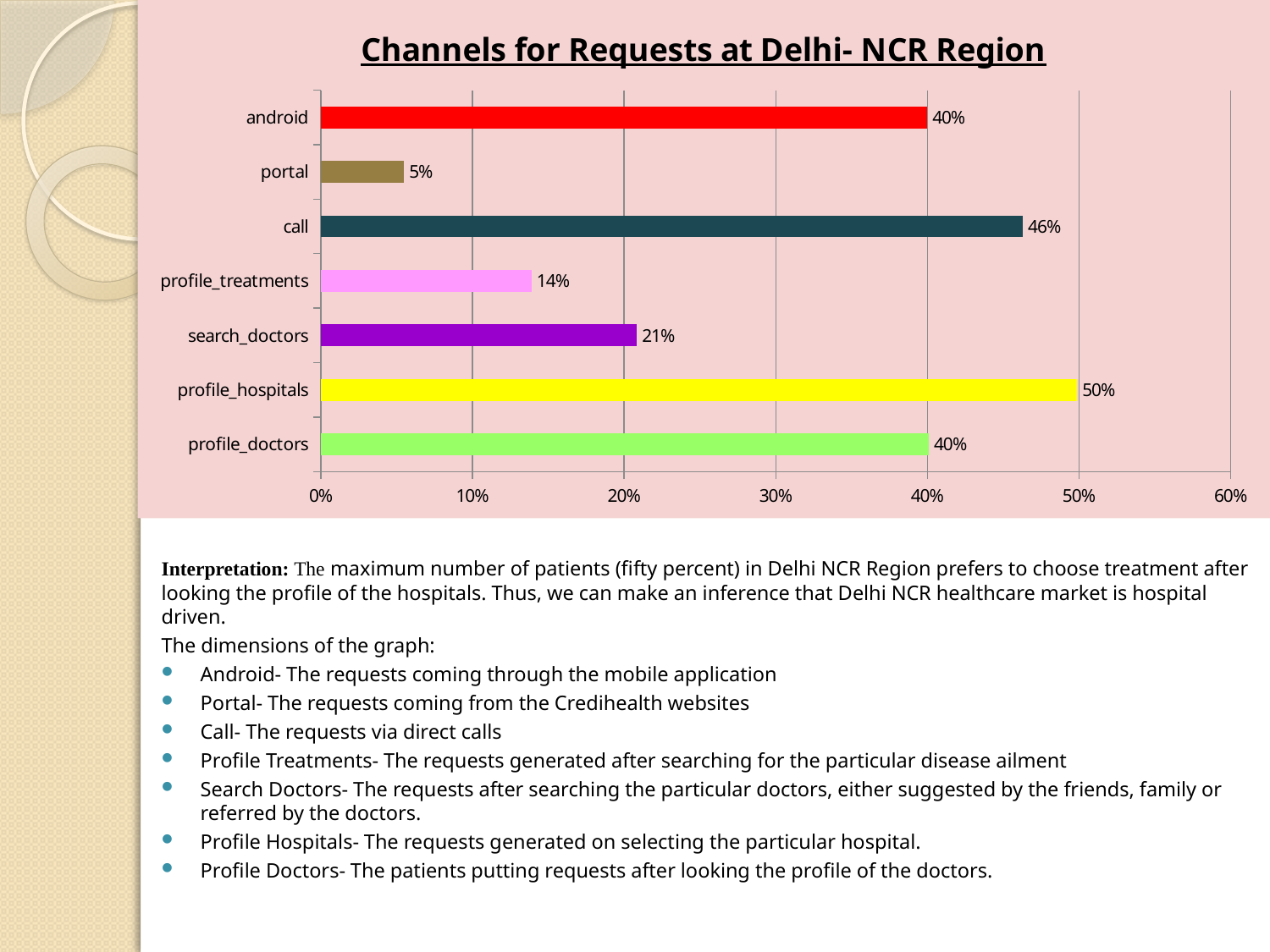
What is the value for portal? 5% Which category has the lowest value? portal What is the difference between the values for profile_hospitals and call? 4% What is the difference between the values for search_doctors and profile_treatments? 7% What is the value for search_doctors? 21% What kind of chart is shown on the slide? bar chart How many categories are shown in the chart? 7 Which category has the highest value? profile_hospitals What is the value for call? 46% What is the title of the chart? Channels for Requests at Delhi- NCR Region What is the value for profile_hospitals? 50% Which is larger, the value for call or the value for android? call